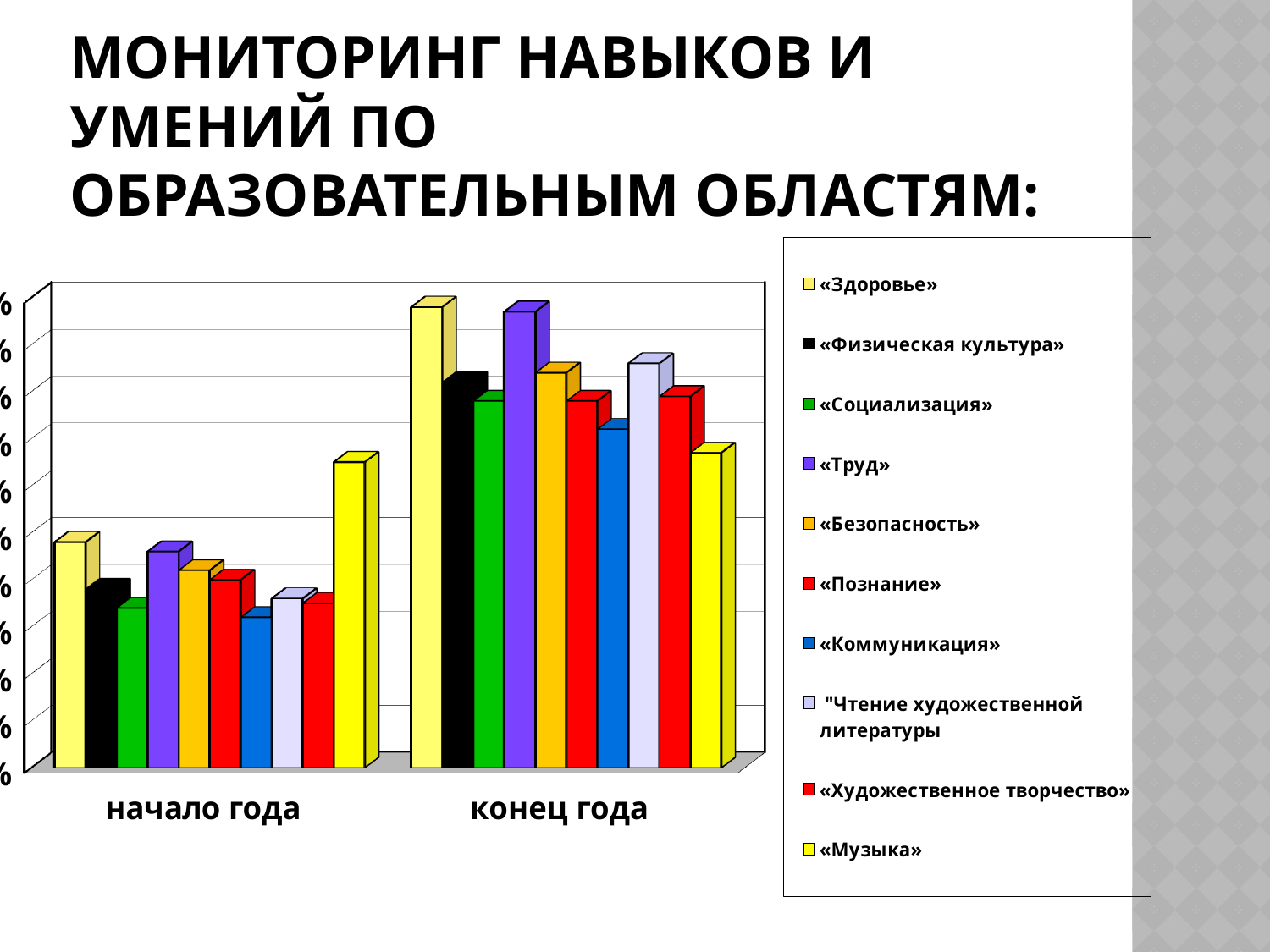
Is the value for «Труд» larger at "начало года" or at "конец года"? конец года Which series is listed first in the chart's legend? «Здоровье» Do the values for «Коммуникация» rise or fall from "начало года" to "конец года"? rise Is the value for «Здоровье» larger at "начало года" or at "конец года"? конец года Do the values for «Познание» rise or fall from "начало года" to "конец года"? rise What are the two categories on the x axis of the chart? начало года, конец года How many categories are shown on the x axis of the chart? 2 Which series has the highest bar in the "начало года" category? «Музыка» What kind of chart is shown on the slide? bar chart Is the value for «Физическая культура» larger at "начало года" or at "конец года"? конец года How many series does the chart's legend list? 10